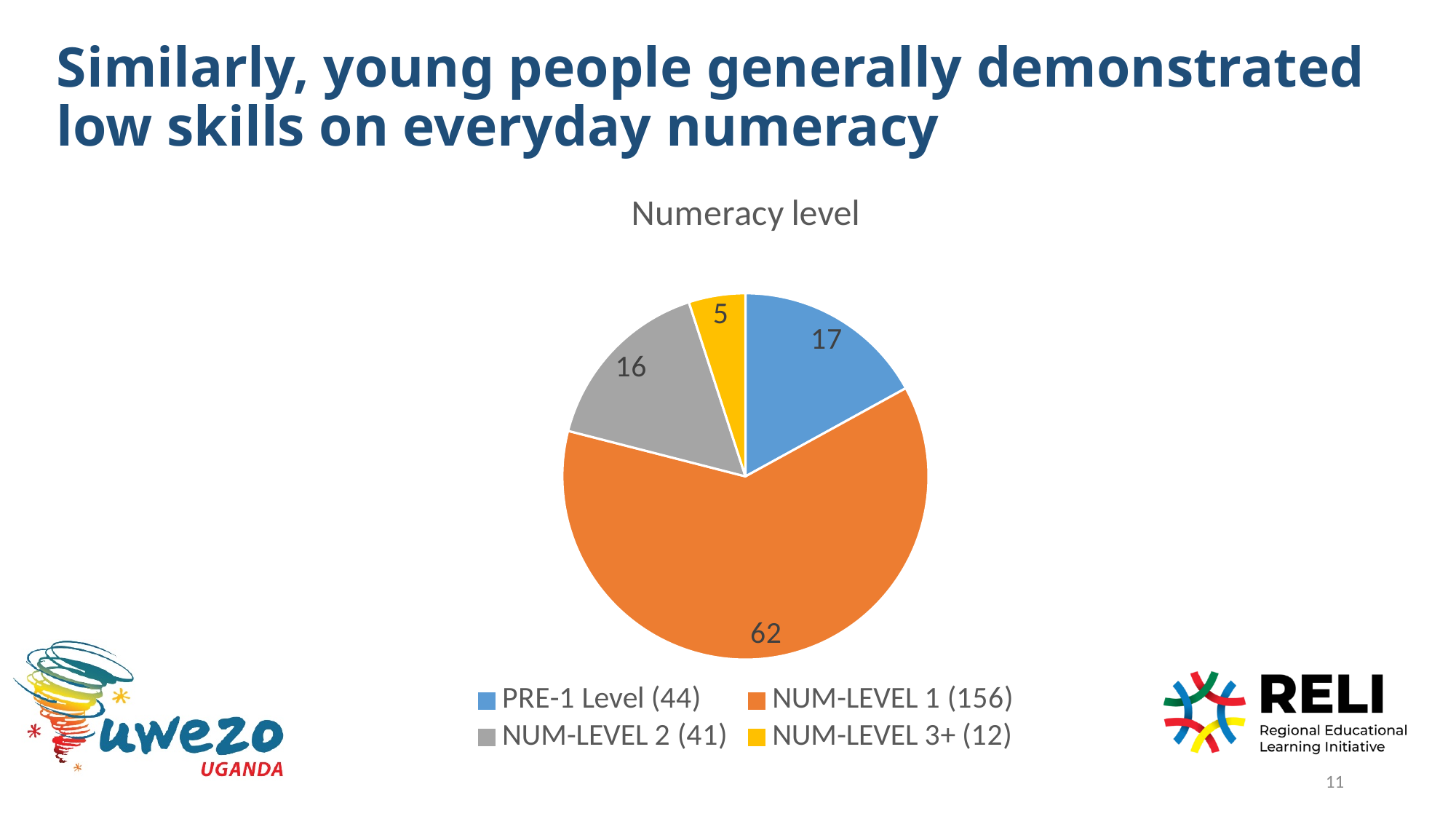
What is the title of the chart? Numeracy level What value is shown for the NUM-LEVEL 3+ (12) slice? 5 How many slices does the pie chart have? 4 Which is larger, the value for PRE-1 Level (44) or NUM-LEVEL 2 (41)? PRE-1 Level (44) What type of chart is shown on the slide? pie chart What value is shown for the NUM-LEVEL 2 (41) slice? 16 What colour is the NUM-LEVEL 2 (41) slice? grey What is the difference between the values for NUM-LEVEL 1 (156) and PRE-1 Level (44)? 45 Which category has the smallest slice of the pie? NUM-LEVEL 3+ (12) What value is shown for the NUM-LEVEL 1 (156) slice? 62 Which category has the largest slice of the pie? NUM-LEVEL 1 (156) What value is shown for the PRE-1 Level (44) slice? 17